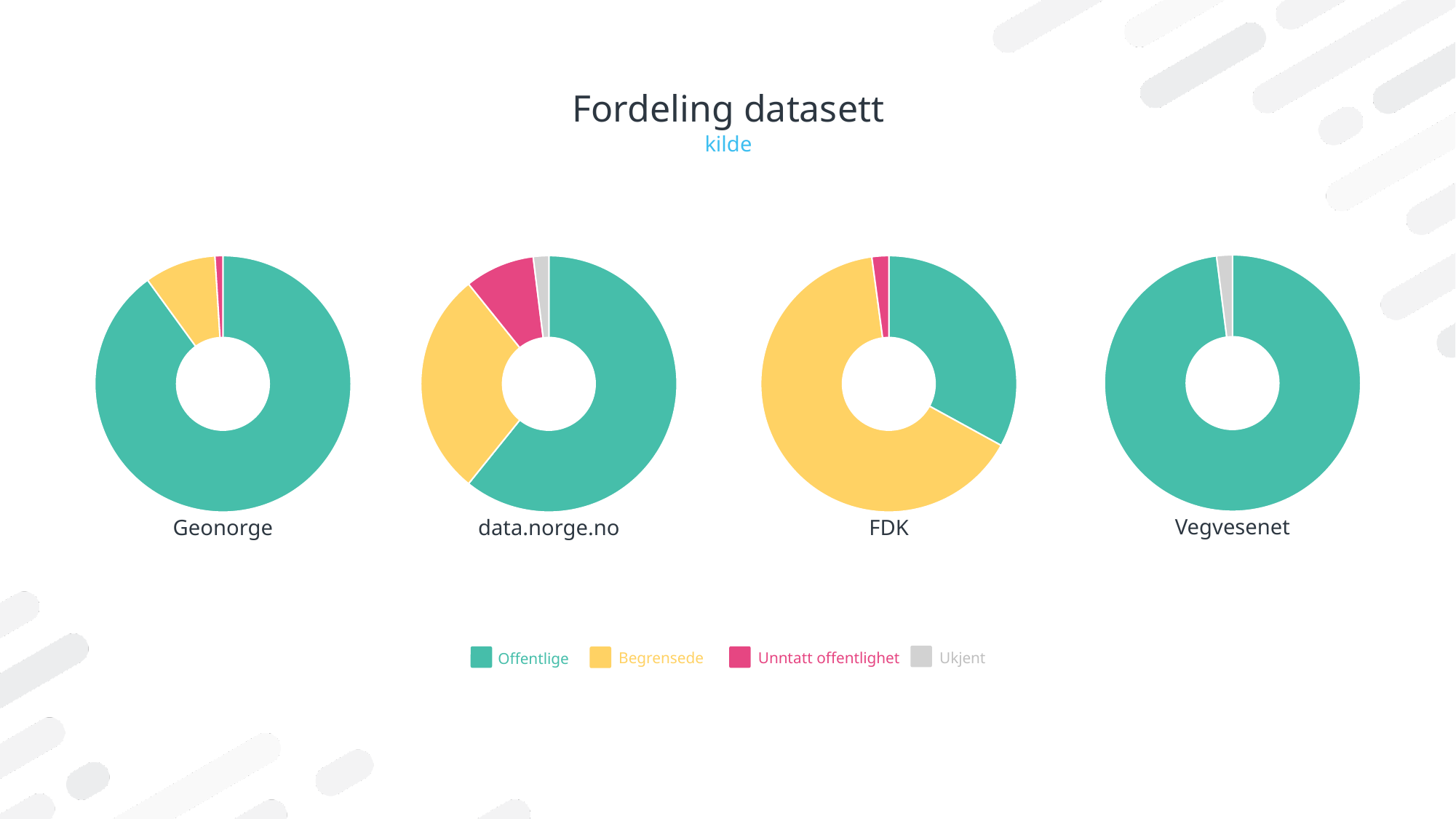
In the data.norge.no chart, which category has the smallest slice? Ukjent In the Geonorge chart, which category has the smallest slice? Unntatt offentlighet In the data.norge.no chart, which slice is larger: Begrensede or Unntatt offentlighet? Begrensede In the FDK chart, which slice is larger: Begrensede or Offentlige? Begrensede How many pie charts are shown on the slide? 4 In the FDK chart, which category has the largest slice? Begrensede In the data.norge.no chart, which category has the largest slice? Offentlige In the Geonorge chart, which category has the largest slice? Offentlige How many entries does the legend list? 4 What kind of chart is used for Geonorge on the slide? pie chart What is the title of the slide's charts? Fordeling datasett